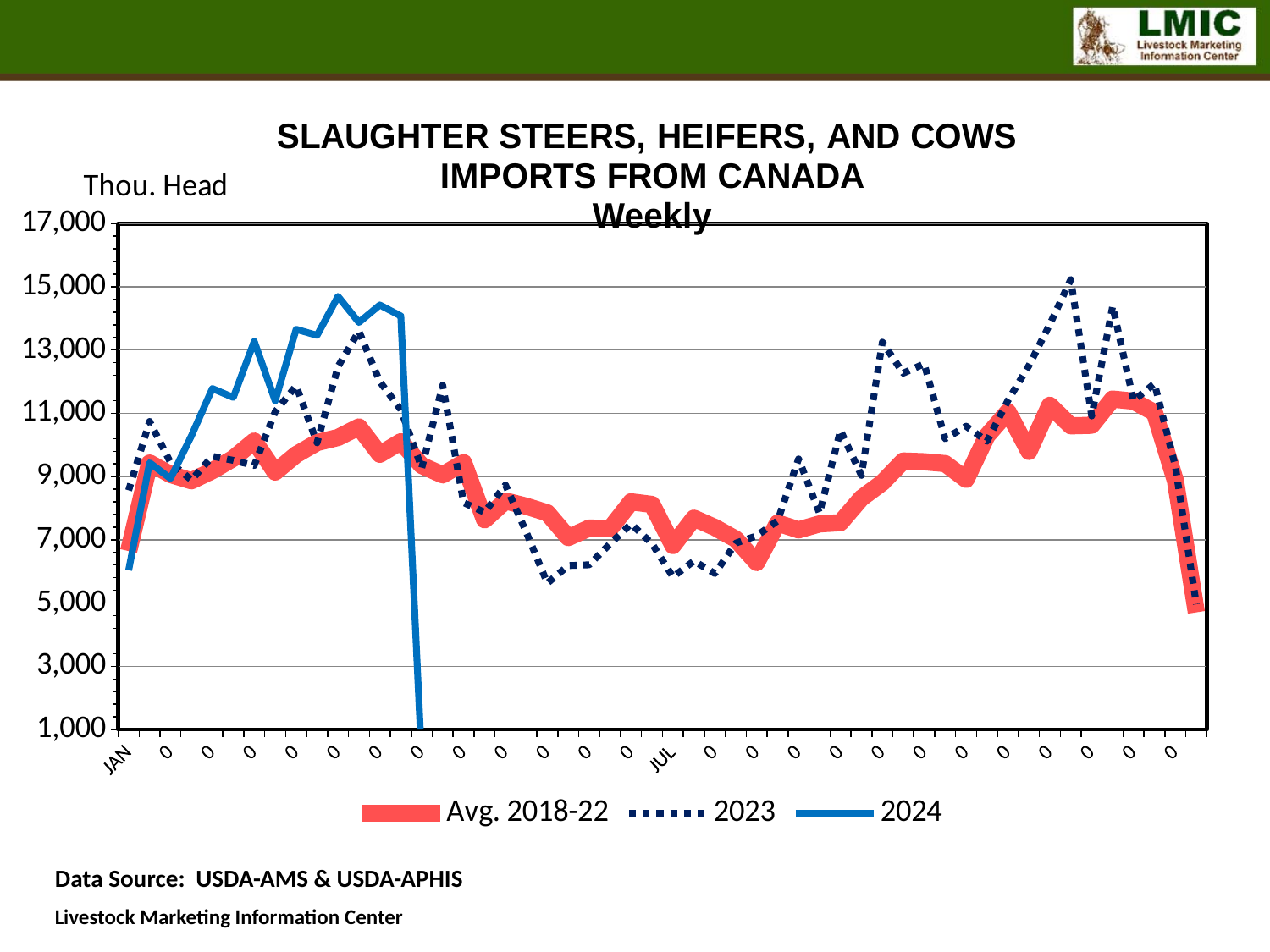
Is the value of the 2023 line at JAN greater or less than 7,000? greater How many series does the legend list? 3 Is the final value of the Avg. 2018-22 line at the right end of the chart greater or less than 7,000? less Is the peak value of the 2024 line greater or less than 13,000? greater What are the three series listed in the legend? Avg. 2018-22, 2023, 2024 At JAN, which is higher: the 2023 line or the 2024 line? 2023 What unit is shown on the y axis of the chart? Thou. Head What kind of chart is shown on the slide? Line chart Does the 2024 line rise or fall from JAN to its peak? rise Which series reaches the highest value anywhere on the chart? 2023